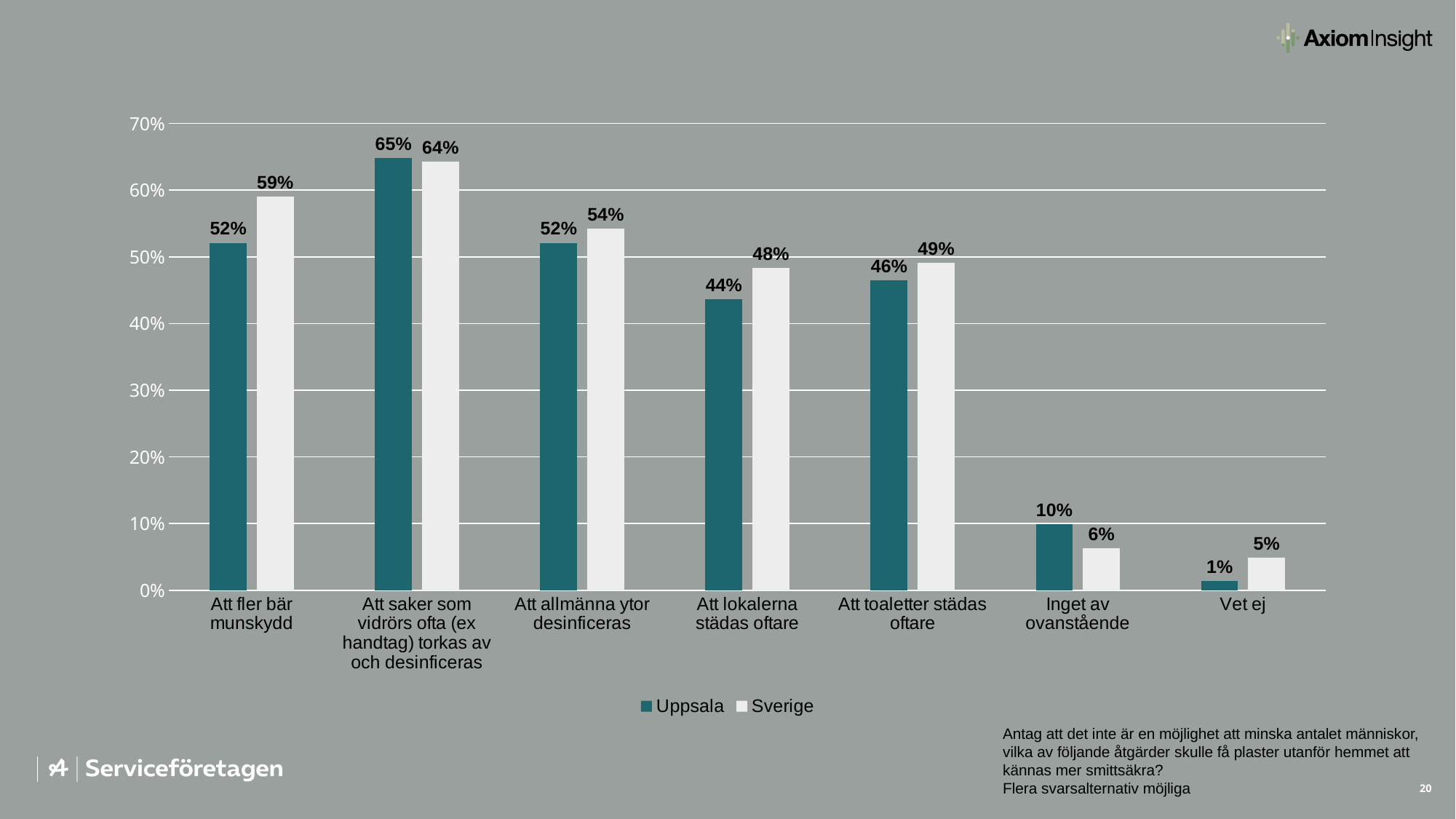
What is the difference between the Sverige and Uppsala values for "Att fler bär munskydd"? 7% Is the Sverige value for "Att allmänna ytor desinficeras" greater or less than 50%? greater How many categories are shown on the x axis? 7 How many series does the legend list? 2 What is the Uppsala value for "Att fler bär munskydd"? 52% What is the Sverige value for "Att lokalerna städas oftare"? 48% For "Att toaletter städas oftare", which is larger, the Uppsala value or the Sverige value? Sverige What is the Uppsala value for "Inget av ovanstående"? 10% What kind of chart is shown on the slide? Bar chart Which series is shown in dark teal in the legend? Uppsala Which category has the highest Uppsala value? Att saker som vidrörs ofta (ex handtag) torkas av och desinficeras Which category has the lowest Sverige value? Vet ej